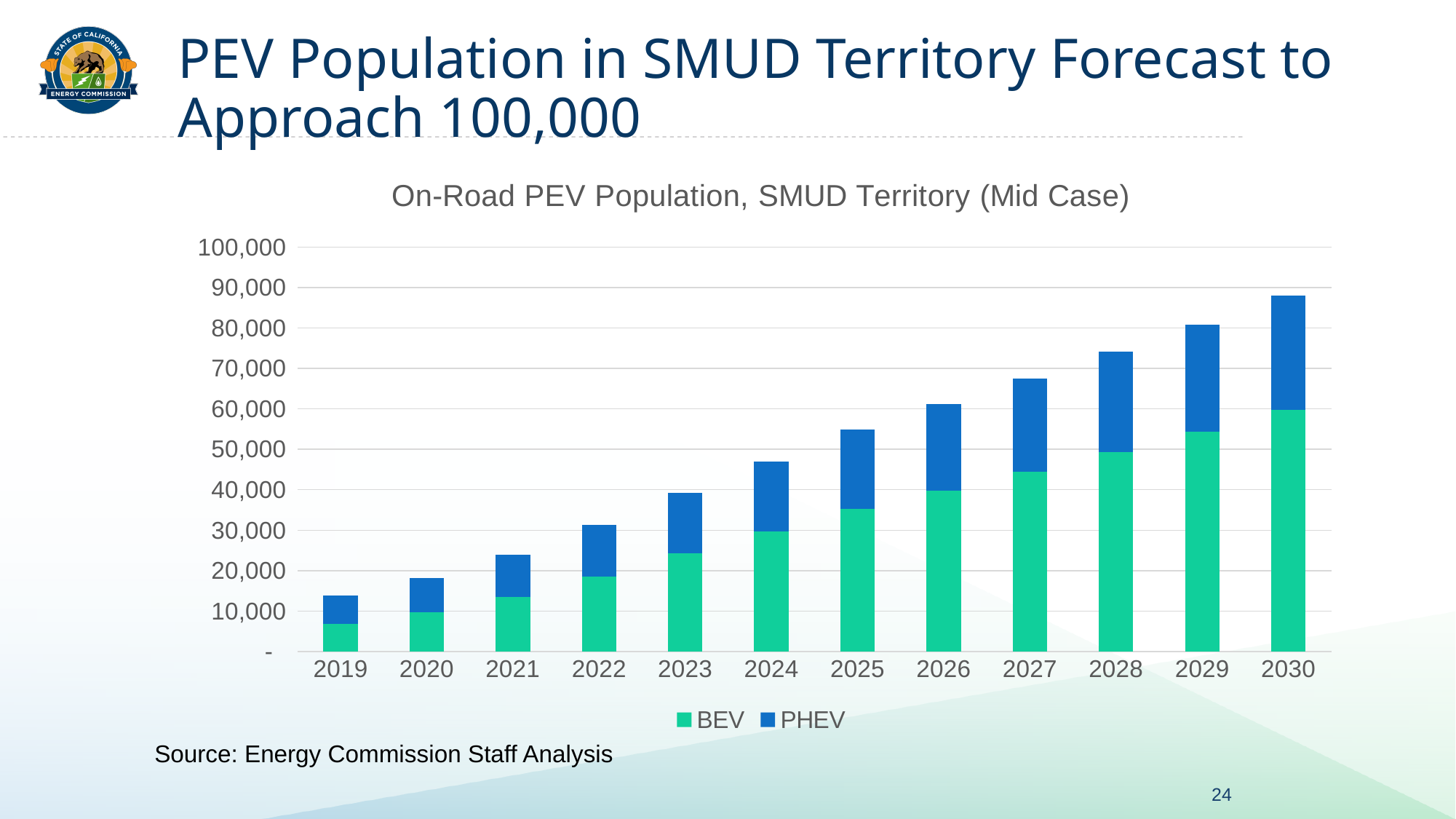
Do the total PEV population values rise or fall from 2019 to 2030? Rise Which year has the highest total on-road PEV population? 2030 Which year has the lowest total on-road PEV population? 2019 How many years are shown on the x axis? 12 Is the BEV value for 2025 greater or less than 40,000? less What is the title of the chart? On-Road PEV Population, SMUD Territory (Mid Case) Is the total PEV population for 2030 greater or less than 80,000? greater How many series does the legend list? 2 What kind of chart is shown on the slide? Stacked bar chart Is the BEV value for 2030 greater or less than 50,000? greater In 2030, which is larger, the BEV segment or the PHEV segment? BEV